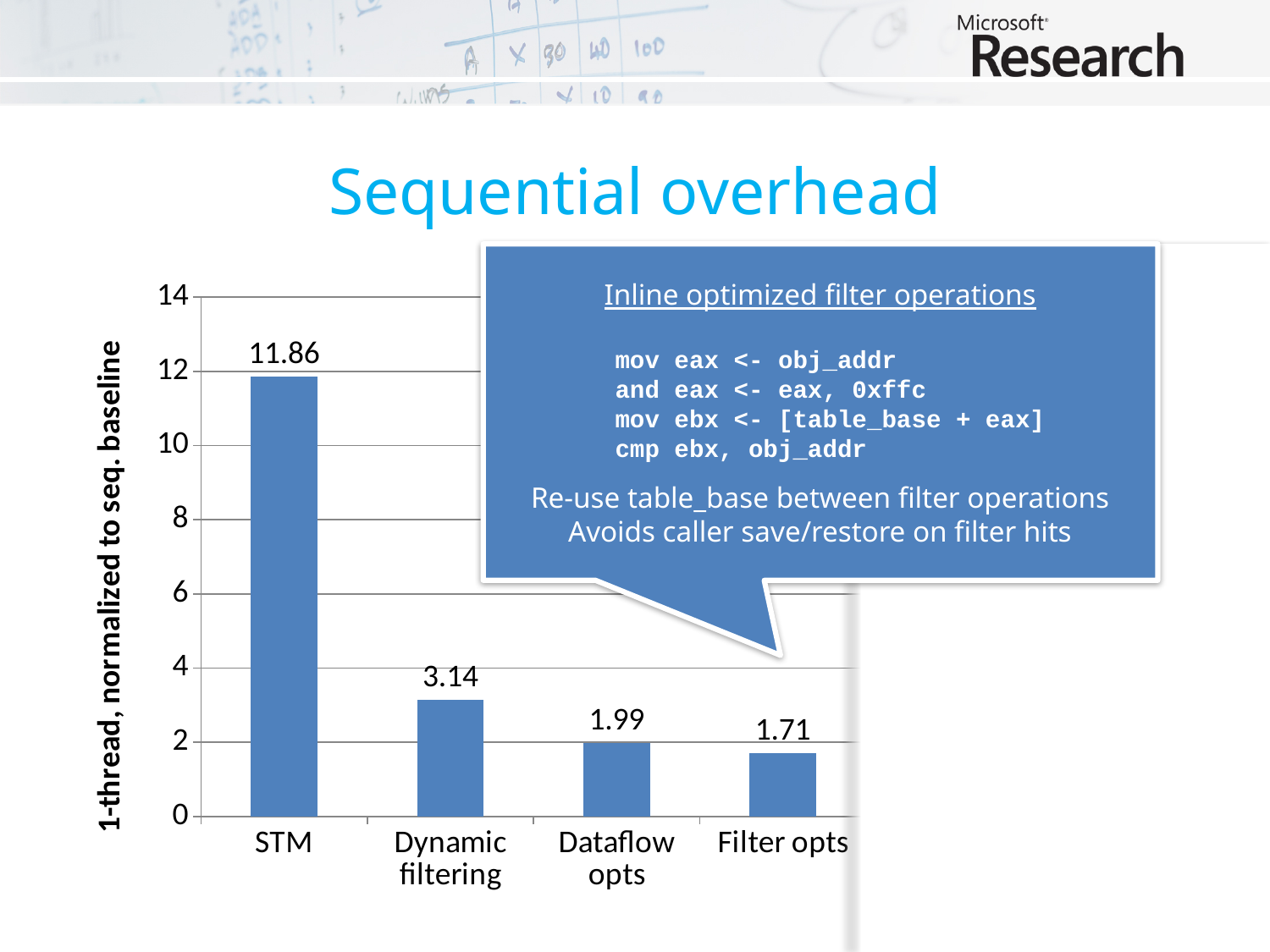
How many categories are shown on the x axis? 4 What is the value for Filter opts? 1.71 What is the difference between the values for Dataflow opts and Filter opts? 0.28 What is the difference between the values for STM and Dynamic filtering? 8.72 What is the value for STM? 11.86 What is the y-axis label of the chart? 1-thread, normalized to seq. baseline Which is larger, the value for Dynamic filtering or the value for Dataflow opts? Dynamic filtering What is the value for Dataflow opts? 1.99 What kind of chart is this? bar chart Which category has the highest value? STM Which category has the lowest value? Filter opts What is the value for Dynamic filtering? 3.14